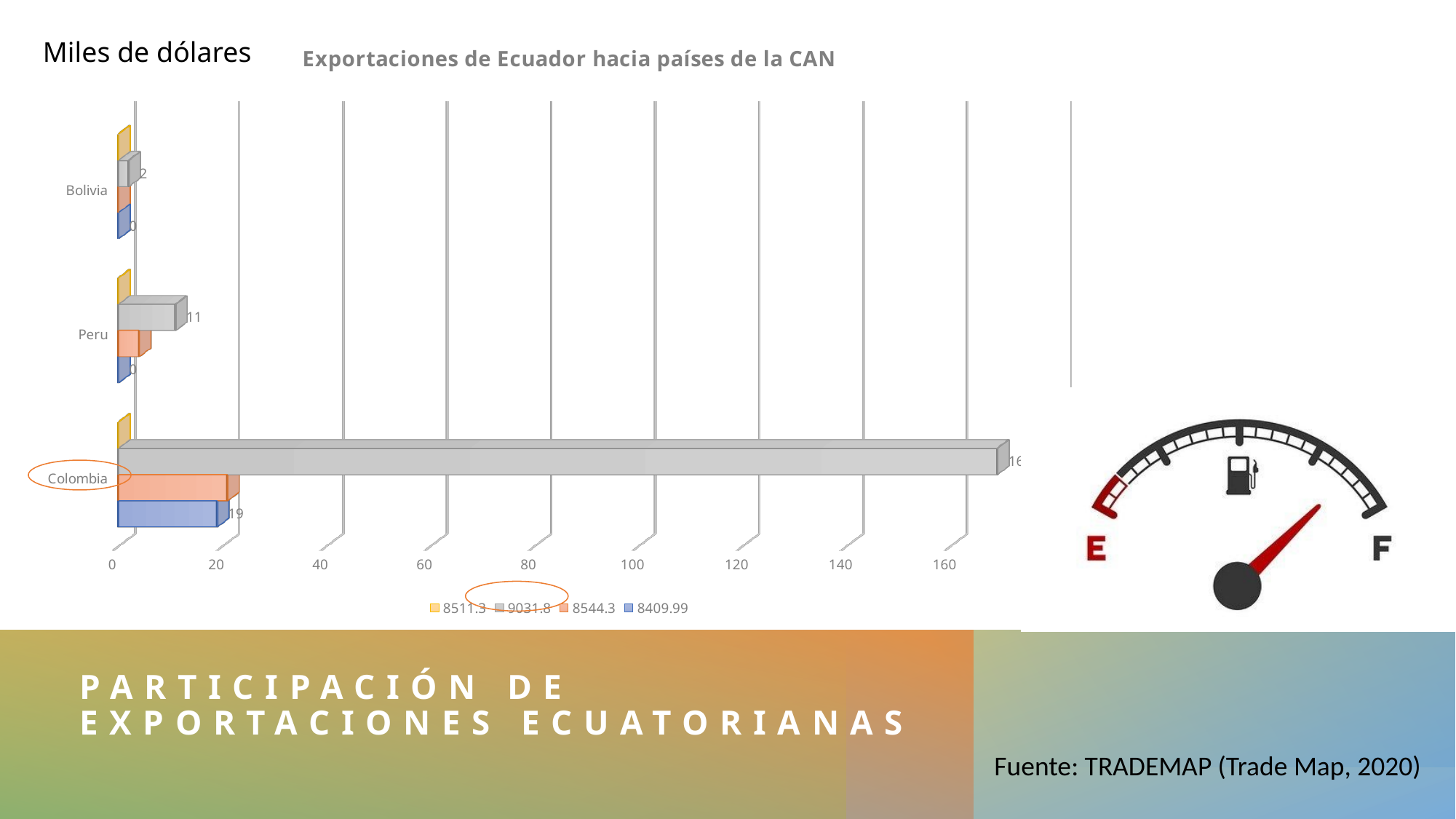
What is the value for Bolivia in the 9031.8 series? 2 What is the difference between the 9031.8 values for Peru and Bolivia? 9 What is the value for Colombia in the 8409.99 series? 19 What is the value for Peru in the 9031.8 series? 11 Which country has the highest value in the 9031.8 series? Colombia What is the title of the chart? Exportaciones de Ecuador hacia países de la CAN How many series does the legend list? 4 How many countries are shown on the chart? 3 What kind of chart is shown on the slide? bar chart What is the value for Peru in the 8409.99 series? 0 Is the value for Colombia in the 9031.8 series greater or less than 160? greater For Peru, which series has the larger value, 9031.8 or 8409.99? 9031.8